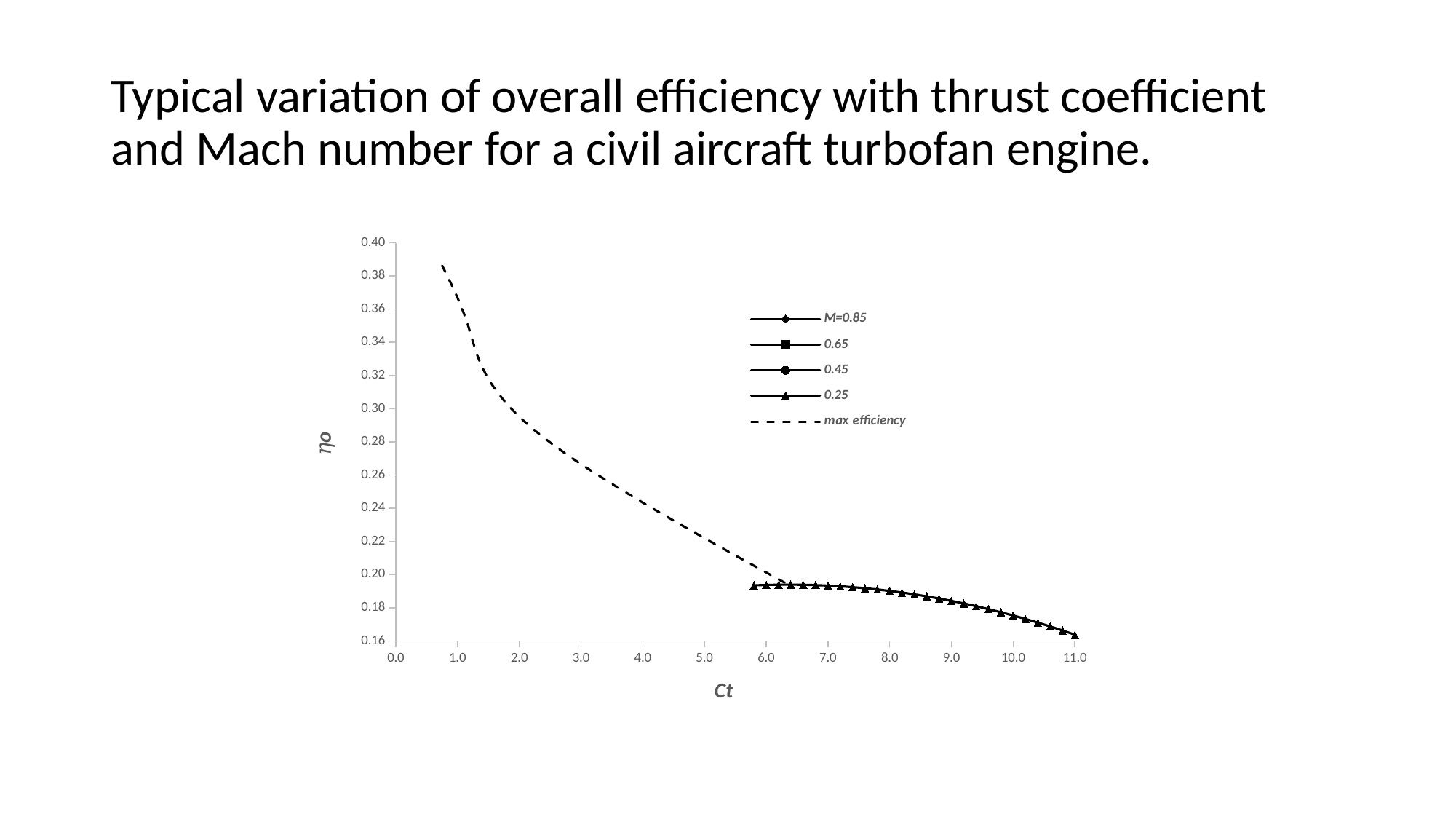
Does the 0.25 series rise or fall as Ct increases from 7.0 to 11.0? fall Is the value of the 0.25 series at Ct = 11.0 greater or less than 0.18? less Which legend entry is drawn as a dashed line? max efficiency At which Ct value does the 0.25 series reach its lowest point? 11.0 How many series does the chart's legend list? 5 Is the max efficiency value at Ct = 3.0 greater or less than 0.24? greater What kind of chart is shown on the slide? line chart Does the max efficiency curve rise or fall as Ct increases? fall Is the max efficiency value at Ct = 5.0 greater or less than 0.24? less What is the label of the x axis? Ct Which is larger: the max efficiency value at Ct = 2.0 or the 0.25 series value at Ct = 8.0? max efficiency at Ct = 2.0